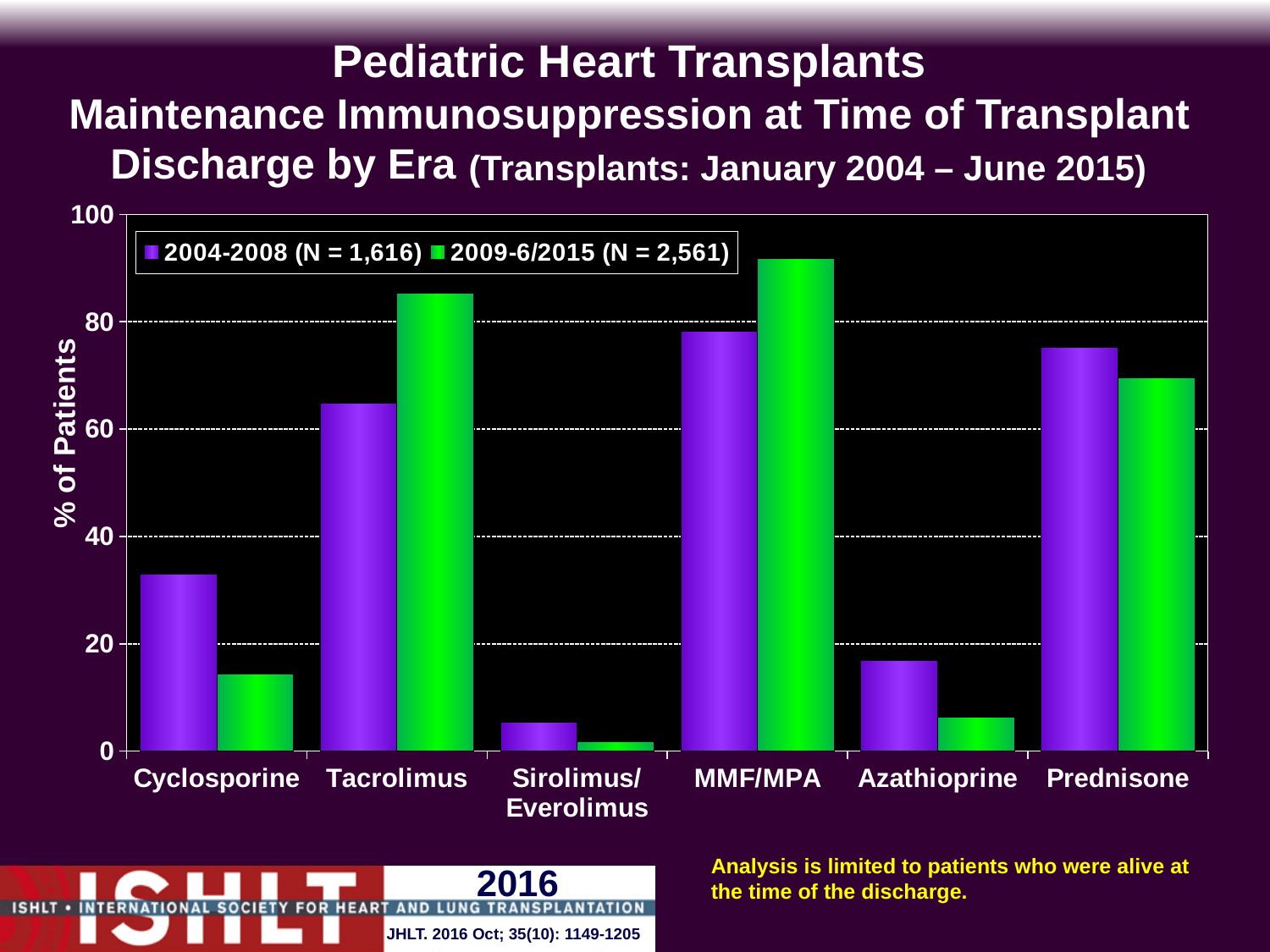
Which drug has the lowest value for the 2009-6/2015 era? Sirolimus/Everolimus Is the value for Tacrolimus in the 2009-6/2015 era greater or less than 80? greater Which drug has the highest value for the 2009-6/2015 era? MMF/MPA For Prednisone, which era has the larger value, 2004-2008 or 2009-6/2015? 2004-2008 Is the value for Azathioprine in the 2009-6/2015 era greater or less than 20? less How many drug categories are shown on the x axis? 6 What kind of chart is shown on the slide? bar chart How many series does the legend list? 2 Which drug has the lowest value for the 2004-2008 era? Sirolimus/Everolimus For Tacrolimus, which era has the larger value, 2004-2008 or 2009-6/2015? 2009-6/2015 Is the value for Cyclosporine in the 2004-2008 era greater or less than 40? less What is the label on the y axis? % of Patients